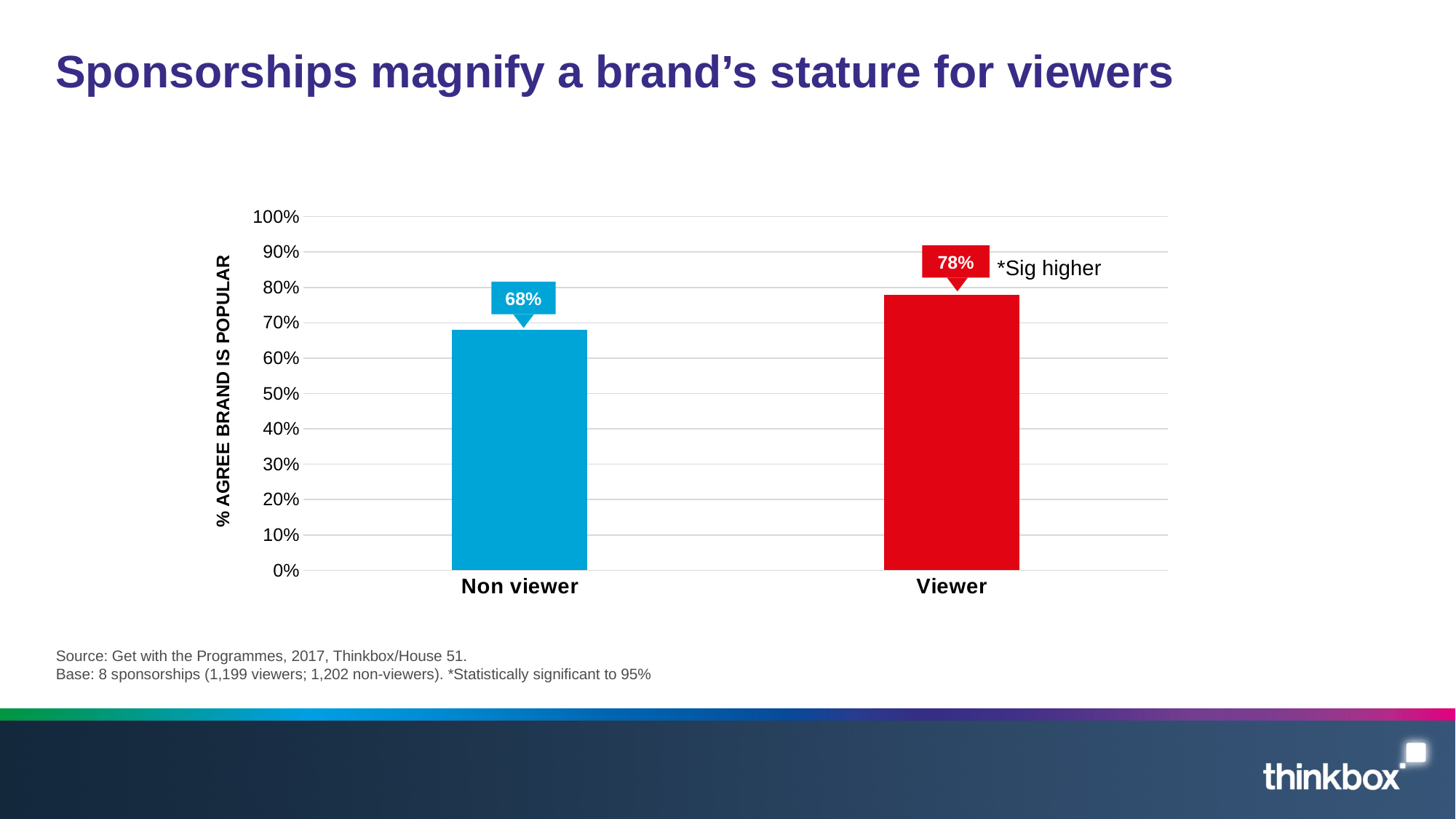
Which is larger, the value for Viewer or the value for Non viewer? Viewer Is the value for Viewer greater or less than 70%? greater How many categories are shown on the x axis? 2 What kind of chart is shown on the slide? bar chart Is the value for Non viewer greater or less than 70%? less What is the label on the vertical axis? % AGREE BRAND IS POPULAR What colour is the Viewer bar? red Which category has the lowest value? Non viewer What is the difference between the Viewer and Non viewer values? 10% What is the value for Non viewer? 68% What is the value for Viewer? 78% Which category has the highest value? Viewer